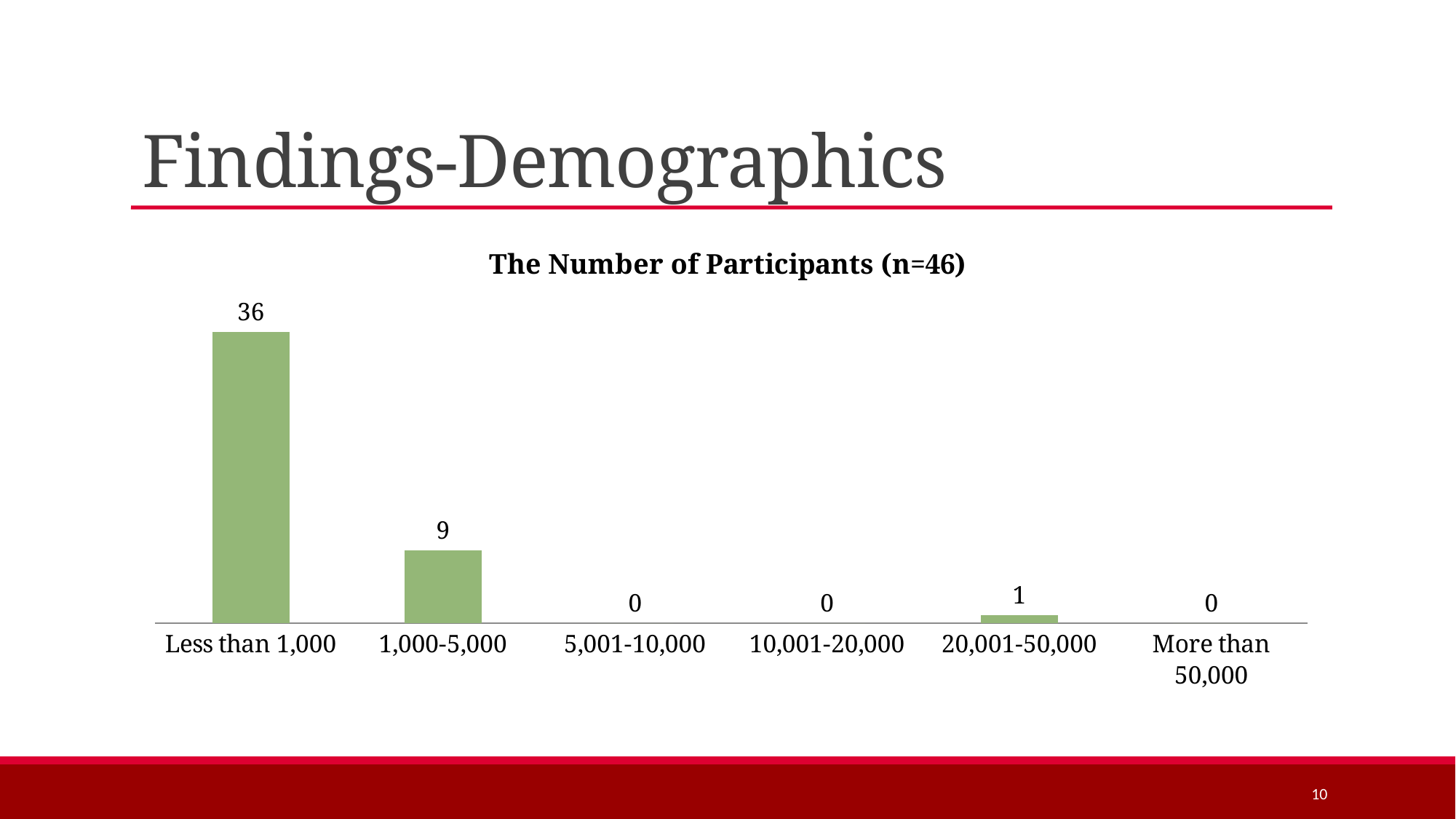
What colour are the bars in the chart? Green Which is larger, the value for '1,000-5,000' or the value for '20,001-50,000'? 1,000-5,000 What kind of chart is shown on the slide? Bar chart How many categories are shown on the x axis? 6 What is the value for the '20,001-50,000' category? 1 Which category has the highest number of participants? Less than 1,000 What is the value for the '1,000-5,000' category? 9 What is the value for the '5,001-10,000' category? 0 What is the difference between the values for 'Less than 1,000' and '1,000-5,000'? 27 What is the value for the 'Less than 1,000' category? 36 How many categories have a value of 0? 3 What is the title of the chart? The Number of Participants (n=46)